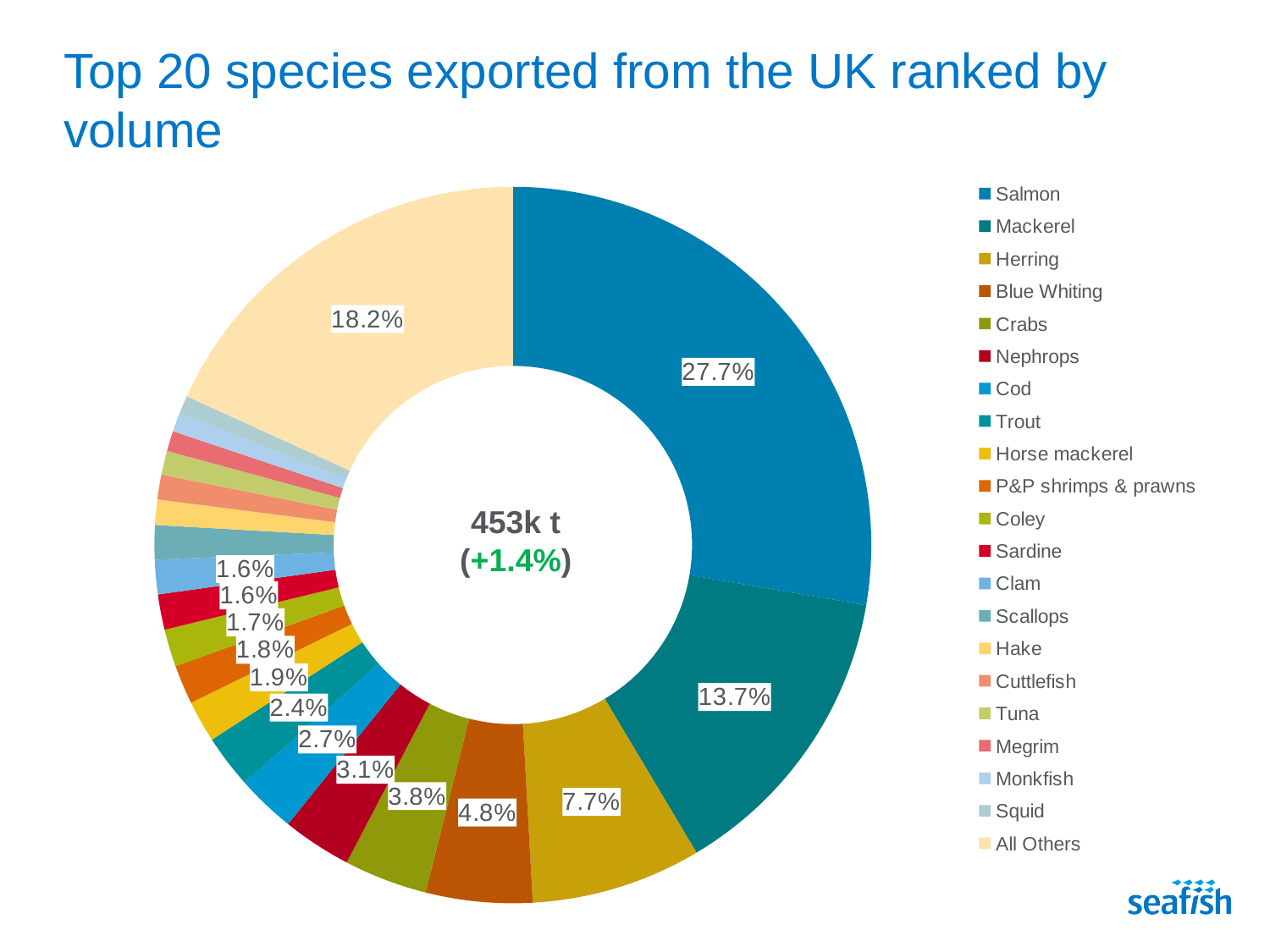
What is the difference in percentage points between the Salmon and Mackerel shares? 14.0 percentage points What percentage is shown for Herring? 7.7% What percentage is shown for Blue Whiting? 4.8% What share is shown for the All Others slice? 18.2% What total volume is shown in the centre of the chart? 453k t What percentage change is shown in the centre of the chart? +1.4% Which species has the largest share of export volume? Salmon How many entries are listed in the legend? 21 What kind of chart is shown on the slide? doughnut chart What percentage is shown for Mackerel? 13.7% Which has the larger share, Herring or Blue Whiting? Herring What share of UK export volume does Salmon account for? 27.7%